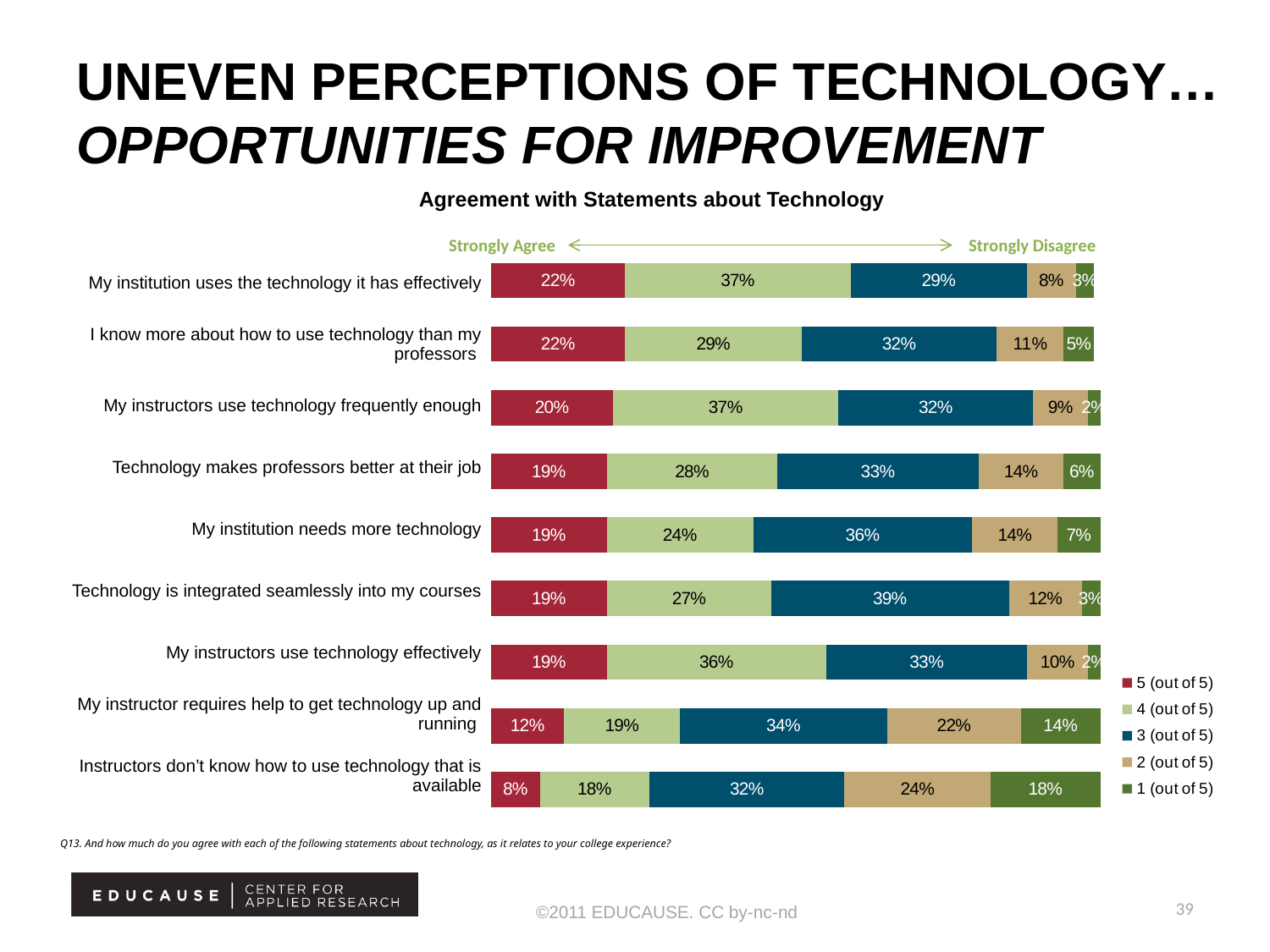
What percentage of respondents gave a 5 (out of 5) for "My institution uses the technology it has effectively"? 22% What is the title of the chart? Agreement with Statements about Technology Which statement has the highest 3 (out of 5) percentage? Technology is integrated seamlessly into my courses How many series does the legend list? 5 How many statements (categories) are plotted in the chart? 9 Which is larger: the 2 (out of 5) percentage for "Technology makes professors better at their job" or for "My instructors use technology effectively"? Technology makes professors better at their job What percentage gave a 1 (out of 5) for "Instructors don't know how to use technology that is available"? 18% What percentage gave a 3 (out of 5) for "Technology is integrated seamlessly into my courses"? 39% What is the difference between the 4 (out of 5) percentages for "My instructors use technology frequently enough" and "My institution needs more technology"? 13% What kind of chart is shown on the slide? Stacked bar chart Which statement has the lowest 5 (out of 5) percentage? Instructors don't know how to use technology that is available What percentage gave a 2 (out of 5) for "My instructor requires help to get technology up and running"? 22%